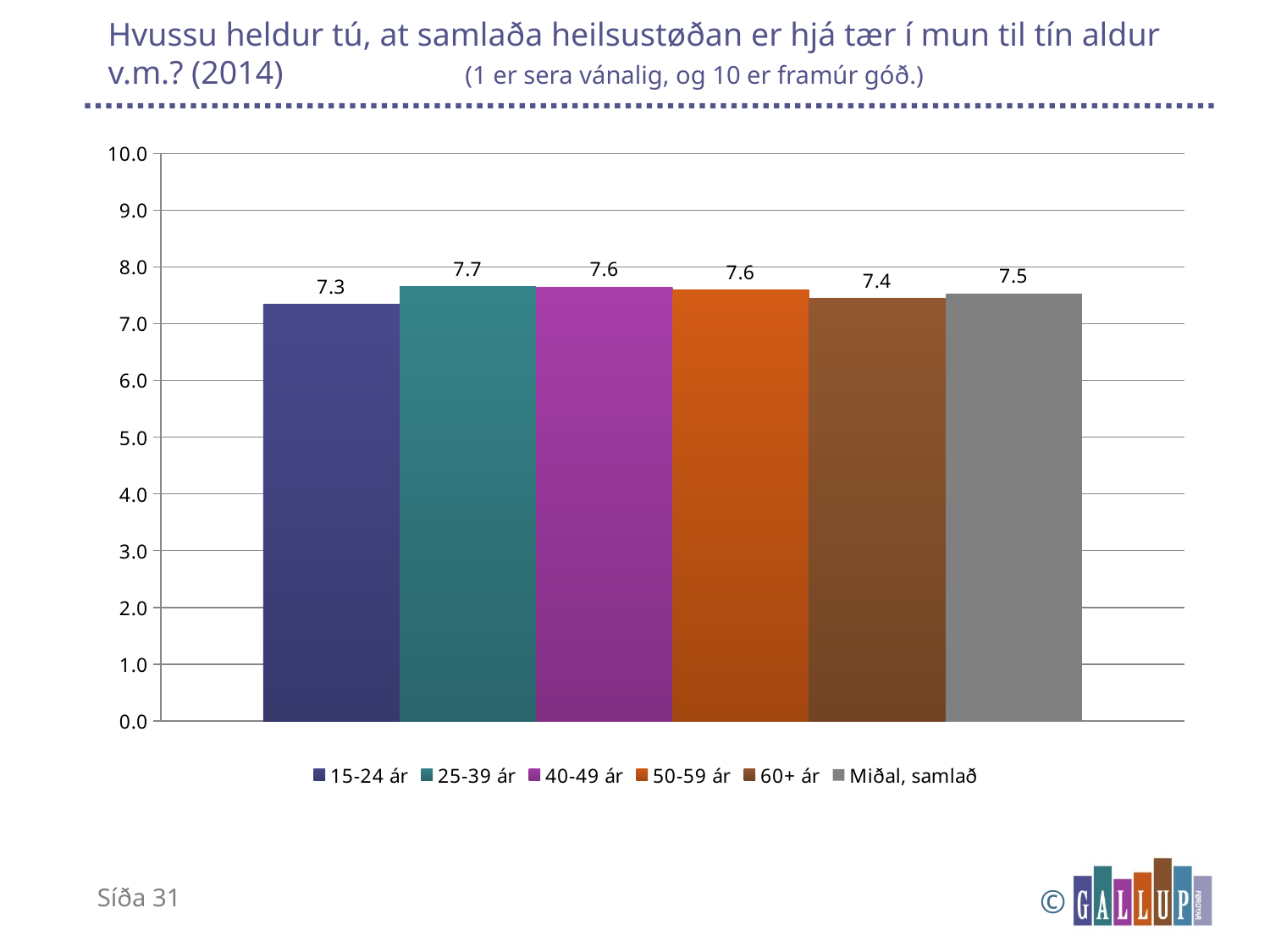
How many bars are plotted in the chart? 6 What is the value for Miðal, samlað? 7.5 Which is larger, the value for 60+ ár or the value for 15-24 ár? 60+ ár What is the value for 15-24 ár? 7.3 How many entries does the legend list? 6 What is the value for 25-39 ár? 7.7 Which age group has the lowest value? 15-24 ár What is the difference between the values for 25-39 ár and 15-24 ár? 0.4 What kind of chart is shown on the slide? bar chart What is the value for 60+ ár? 7.4 Which age group has the highest value? 25-39 ár Is the value for 50-59 ár greater or less than 8.0? less